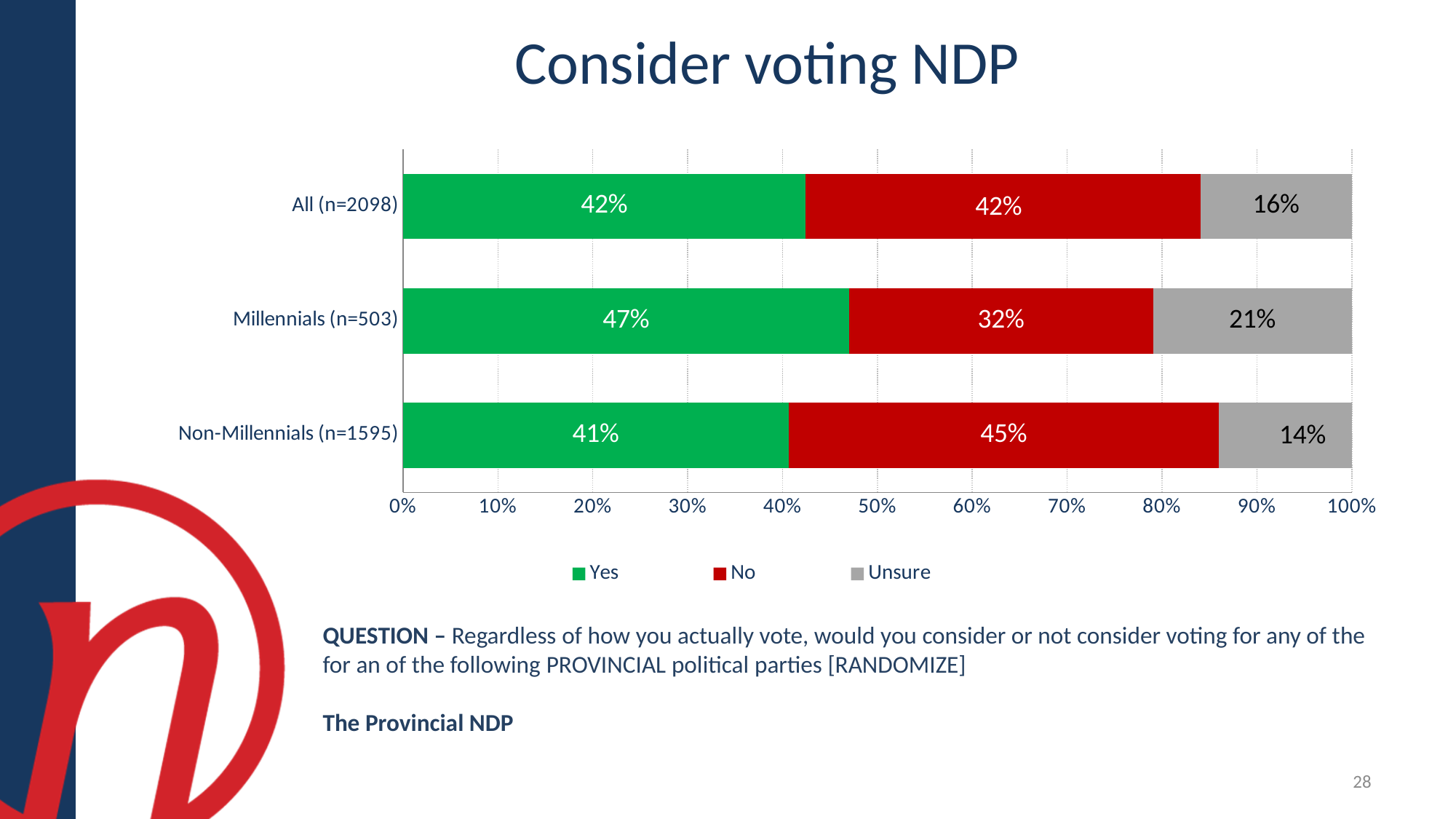
What percentage of All (n=2098) answered Unsure? 16% What percentage of Millennials (n=503) answered Yes? 47% Which is larger: the Unsure percentage for Millennials (n=503) or for All (n=2098)? Millennials (n=503) What is the difference between the No percentage for Non-Millennials (n=1595) and for Millennials (n=503)? 13% What kind of chart is shown on the slide? Stacked bar chart How many groups are shown on the chart? 3 How many series does the legend list? 3 What percentage of Non-Millennials (n=1595) answered No? 45% What is the total of the stacked bar for Millennials (n=503)? 100% Which group has the lowest Unsure percentage? Non-Millennials (n=1595) What is the title of the chart? Consider voting NDP Which group has the highest Yes percentage? Millennials (n=503)